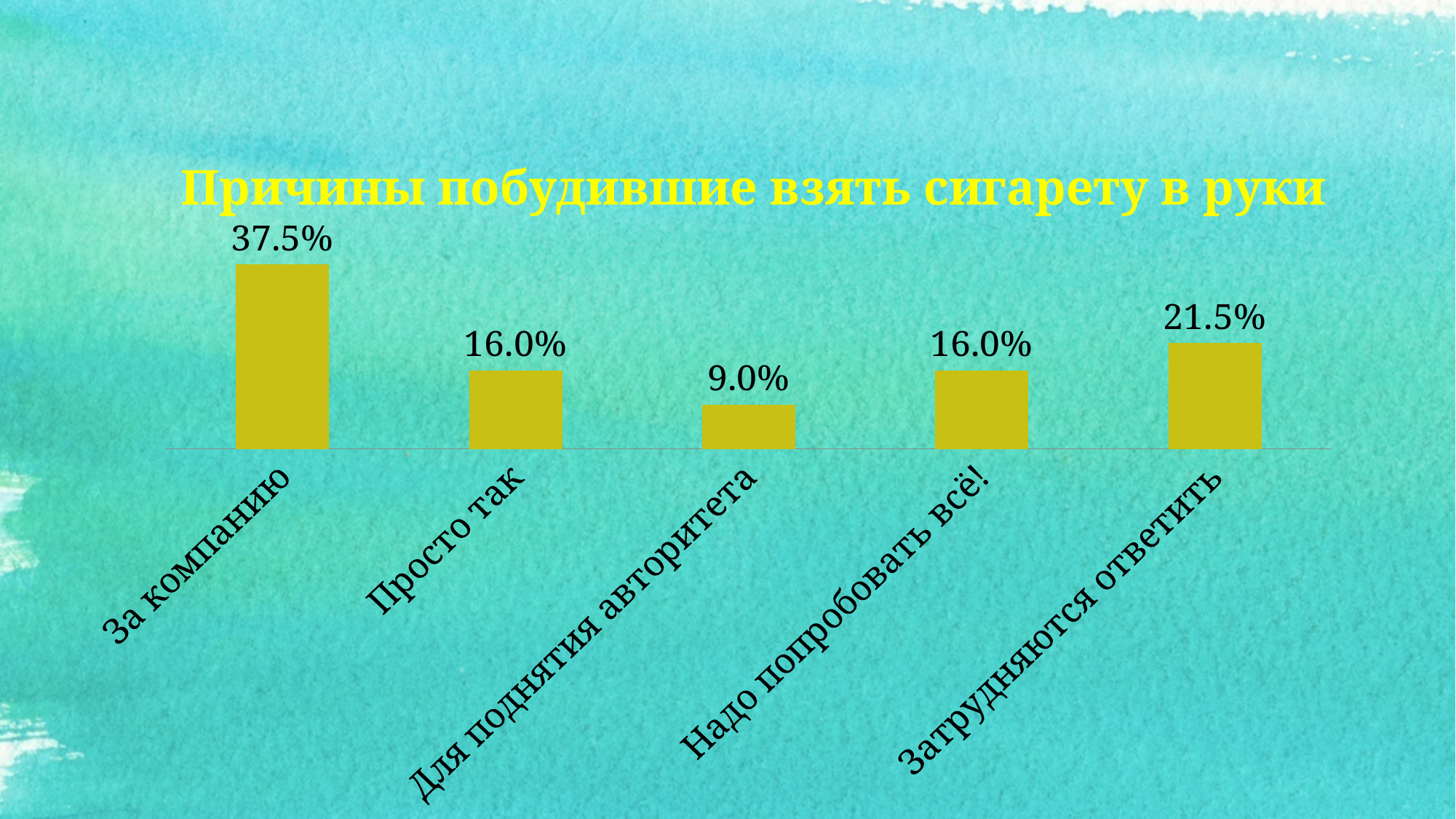
What is the value for "Для поднятия авторитета"? 9.0% What is the difference between "За компанию" and "Затрудняются ответить"? 16.0% Which is larger: "Затрудняются ответить" or "Надо попробовать всё!"? Затрудняются ответить Which category has the lowest value? Для поднятия авторитета What is the title of the chart? Причины побудившие взять сигарету в руки Which category has the highest value? За компанию What is the value for "За компанию"? 37.5% How many categories are shown in the chart? 5 What is the value for "Просто так"? 16.0% What is the value for "Затрудняются ответить"? 21.5% What is the difference between "Просто так" and "Для поднятия авторитета"? 7.0% What kind of chart is shown on the slide? Bar chart